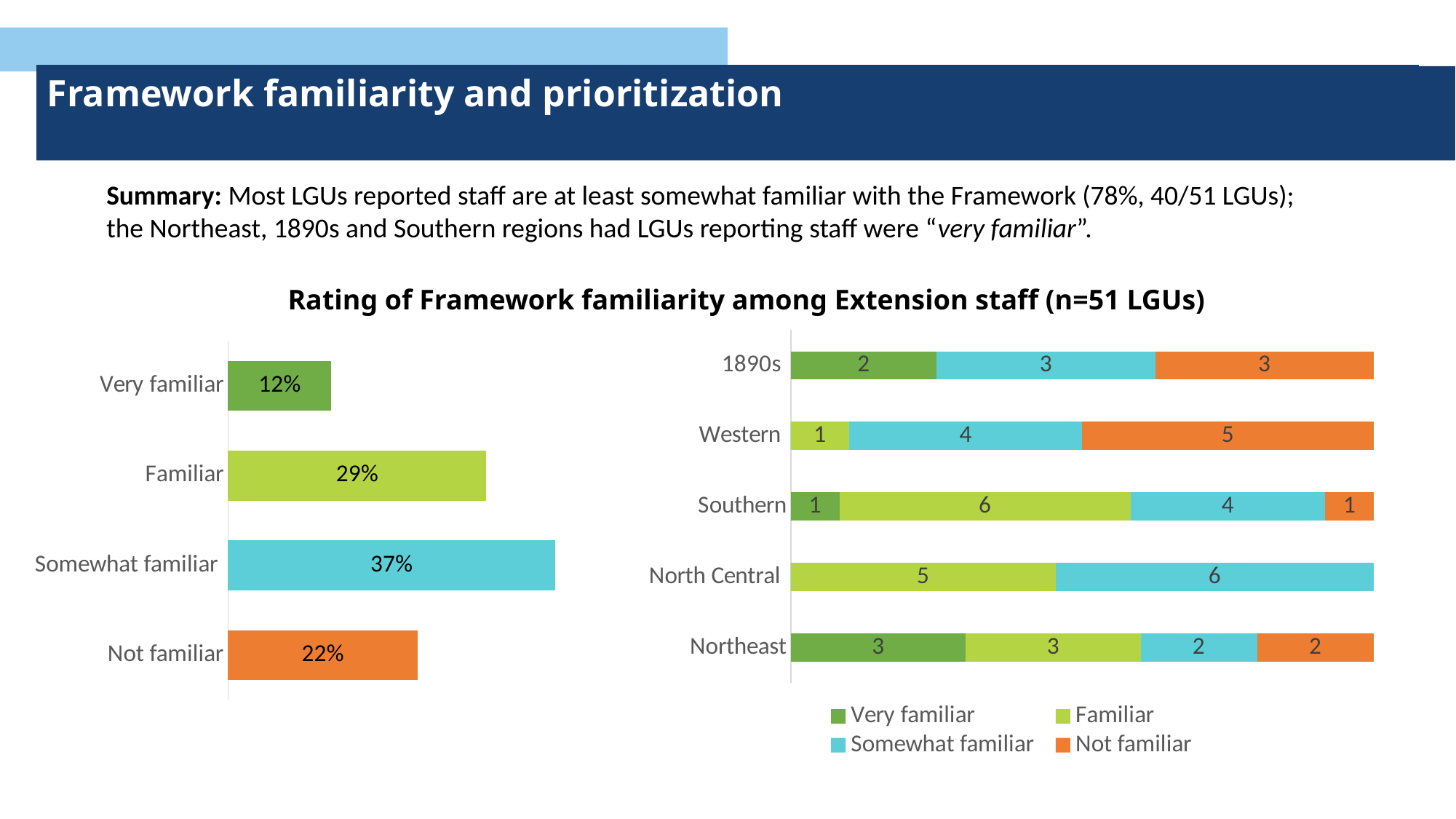
In the right chart, how many LGUs in the Western region reported staff were 'Not familiar'? 5 In the right chart, which region has more LGUs reporting 'Very familiar': Northeast or 1890s? Northeast In the left chart, which familiarity rating has the lowest percentage? Very familiar In the right chart, how many LGUs in the Southern region reported staff were 'Familiar'? 6 In the right chart, what is the total number of LGUs in the Northeast region? 10 What type of chart is the right chart? Stacked bar chart In the left chart, what is the difference between the 'Familiar' and 'Not familiar' percentages? 7% In the right chart, what is the total number of LGUs in the Southern region? 12 In the left chart, which familiarity rating has the highest percentage? Somewhat familiar In the left chart, how many familiarity categories are shown? 4 In the left chart, what percentage of LGUs rated staff as 'Somewhat familiar'? 37% In the right chart, how many series does the legend list? 4